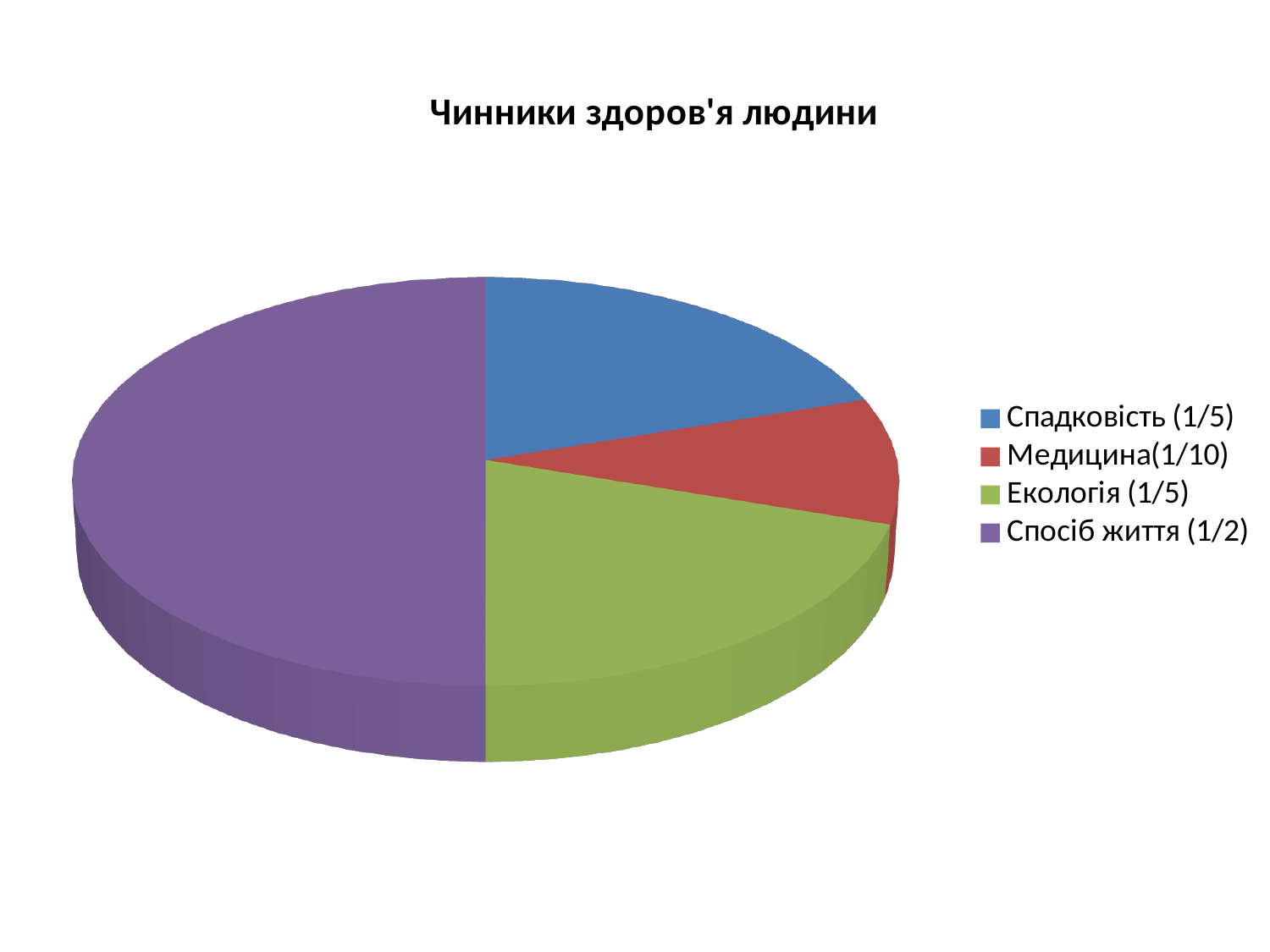
What is the title of the chart? Чинники здоров'я людини How many slices does the pie chart have? 4 Which category has the largest slice of the pie? Спосіб життя (1/2) What share of the pie does Медицина represent, according to the legend? 1/10 What share of the pie does Спосіб життя represent, according to the legend? 1/2 What kind of chart is shown on the slide? pie chart What share of the pie does Спадковість represent, according to the legend? 1/5 Which category has the smallest slice of the pie? Медицина(1/10) What colour is the slice for Спосіб життя? purple Which slice is larger: Спосіб життя or Спадковість? Спосіб життя Which slice is larger: Екологія or Медицина? Екологія